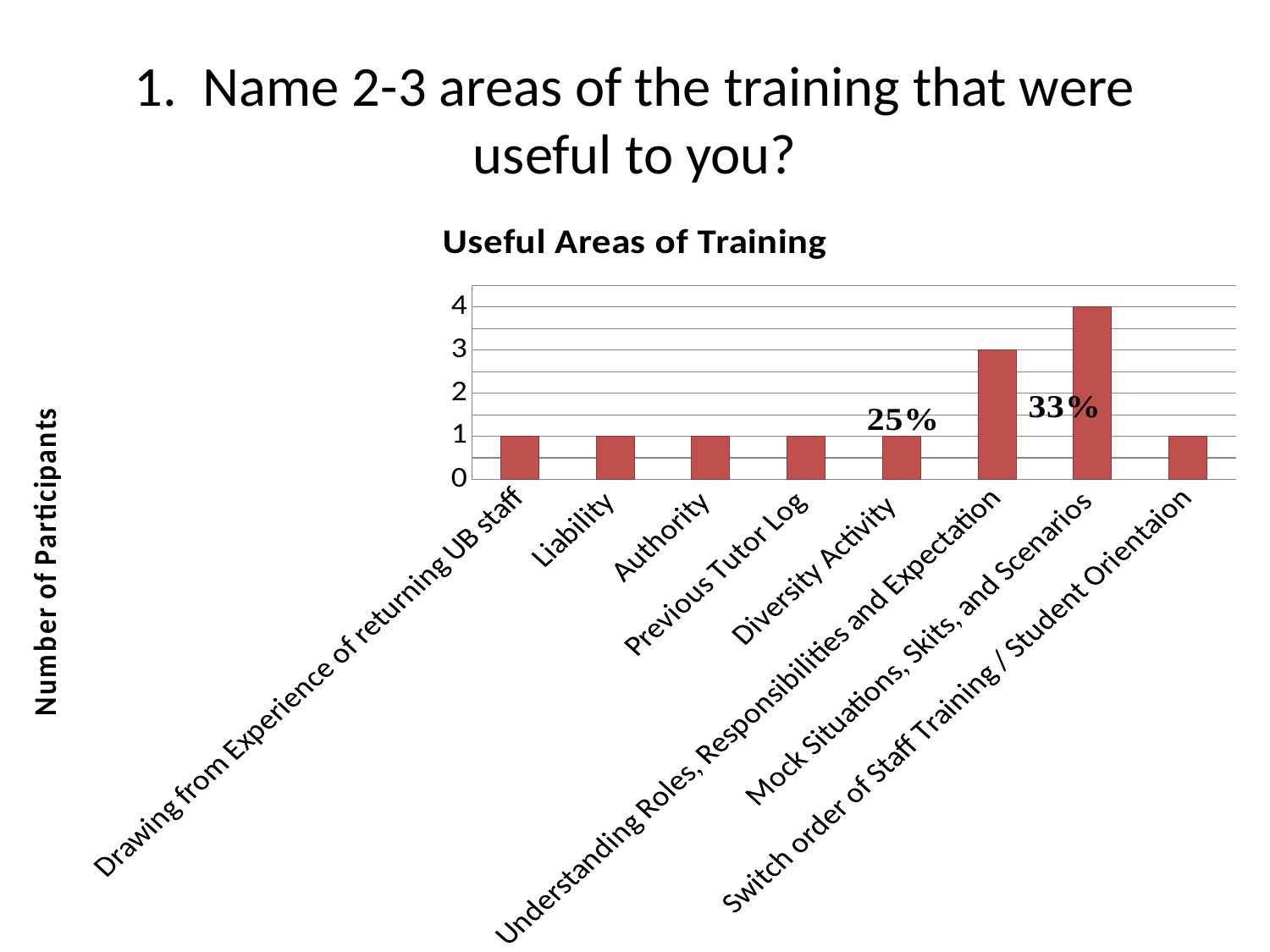
Is the value for Mock Situations, Skits, and Scenarios greater or less than 2? greater What kind of chart is shown on the slide? bar chart What is the number of participants for Understanding Roles, Responsibilities and Expectation? 3 What is the number of participants for Switch order of Staff Training / Student Orientaion? 1 What is the title of the chart? Useful Areas of Training How many categories are shown on the x axis of the chart? 8 What is the number of participants for Liability? 1 What is the number of participants for Mock Situations, Skits, and Scenarios? 4 What is the label on the vertical axis of the chart? Number of Participants What is the difference in participants between Mock Situations, Skits, and Scenarios and Understanding Roles, Responsibilities and Expectation? 1 Which category has the highest number of participants? Mock Situations, Skits, and Scenarios Which has more participants, Diversity Activity or Understanding Roles, Responsibilities and Expectation? Understanding Roles, Responsibilities and Expectation